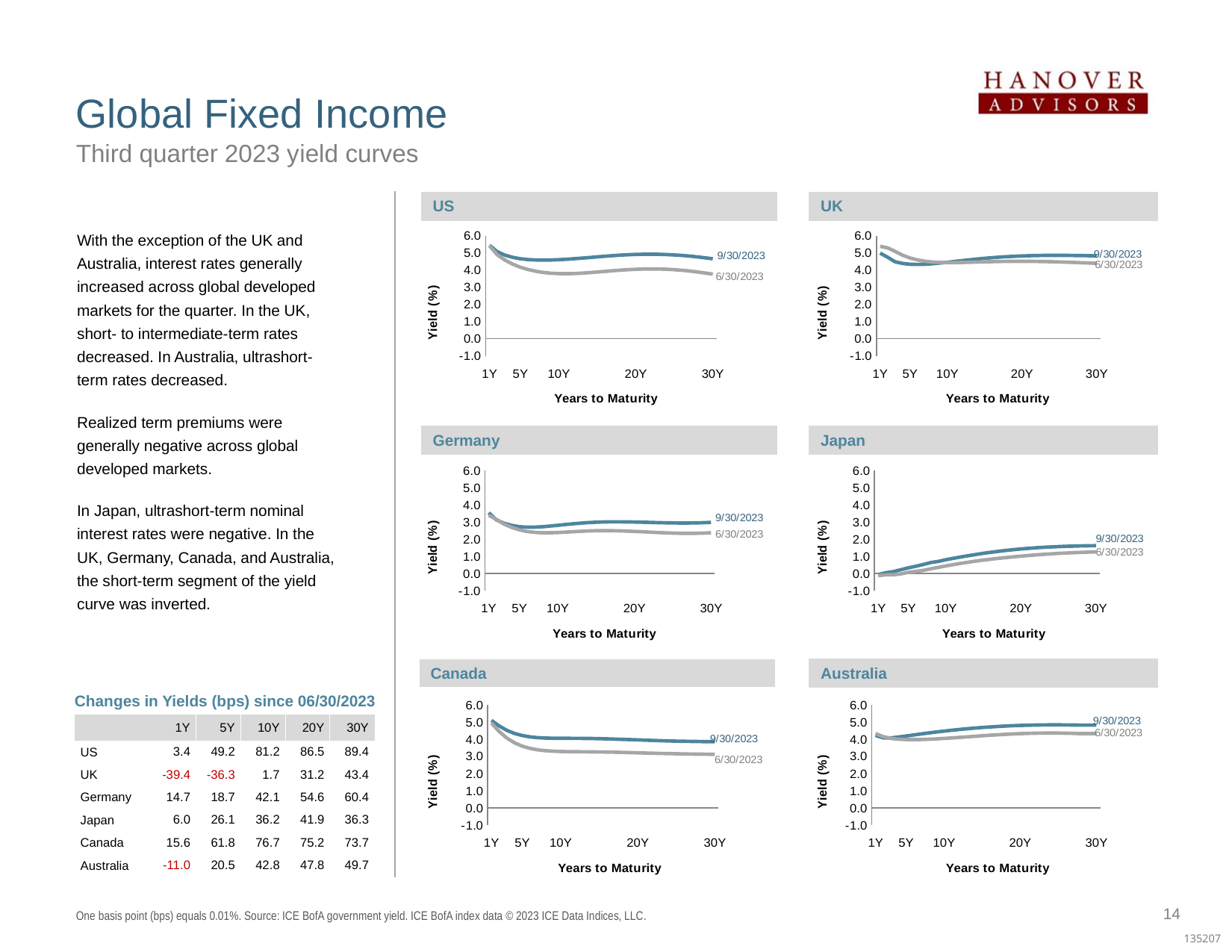
What is the y-axis title of the Australia chart? Yield (%) In the UK chart, is the 6/30/2023 yield at 1Y greater or less than 5.0? greater In the Canada chart, does the 9/30/2023 yield rise or fall from 1Y to 30Y? fall In the US chart, which series is higher at 10Y, 9/30/2023 or 6/30/2023? 9/30/2023 In the Japan chart, is the 9/30/2023 yield at 30Y greater or less than 1.0? greater How many maturity points are labelled on the x axis of the Germany chart? 5 In the Japan chart, is the 9/30/2023 yield at 1Y greater or less than 1.0? less What kind of chart is the US chart? line chart In the Japan chart, does the 9/30/2023 yield rise or fall from 1Y to 30Y? rise